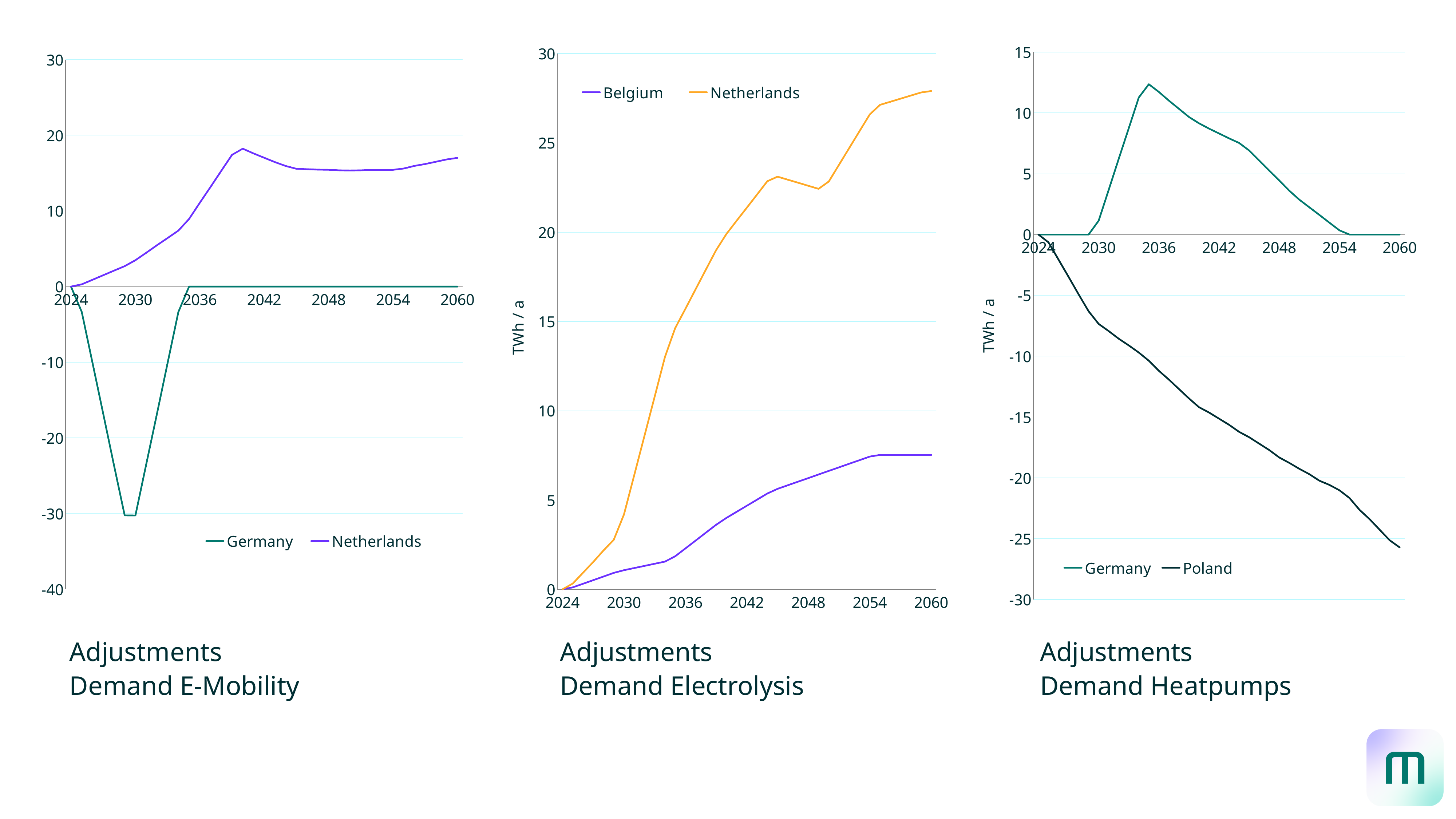
In the 'Adjustments Demand E-Mobility' chart, is the value for Germany in 2030 greater or less than -20? less In the 'Adjustments Demand E-Mobility' chart, is the value for Netherlands in 2060 greater or less than 10? greater In the 'Adjustments Demand Heatpumps' chart, does the Poland series rise or fall from 2024 to 2060? fall In the 'Adjustments Demand Electrolysis' chart, is the value for Netherlands in 2060 greater or less than 25? greater In the 'Adjustments Demand Electrolysis' chart, which series is higher in 2060, Belgium or Netherlands? Netherlands What is the y-axis label on the 'Adjustments Demand Heatpumps' chart? TWh / a In the 'Adjustments Demand Heatpumps' chart, which two series are shown in the legend? Germany and Poland What kind of chart is the 'Adjustments Demand E-Mobility' chart? line chart How many series does the legend of the 'Adjustments Demand Electrolysis' chart list? 2 In the 'Adjustments Demand Electrolysis' chart, does the Netherlands series generally rise or fall from 2024 to 2060? rise